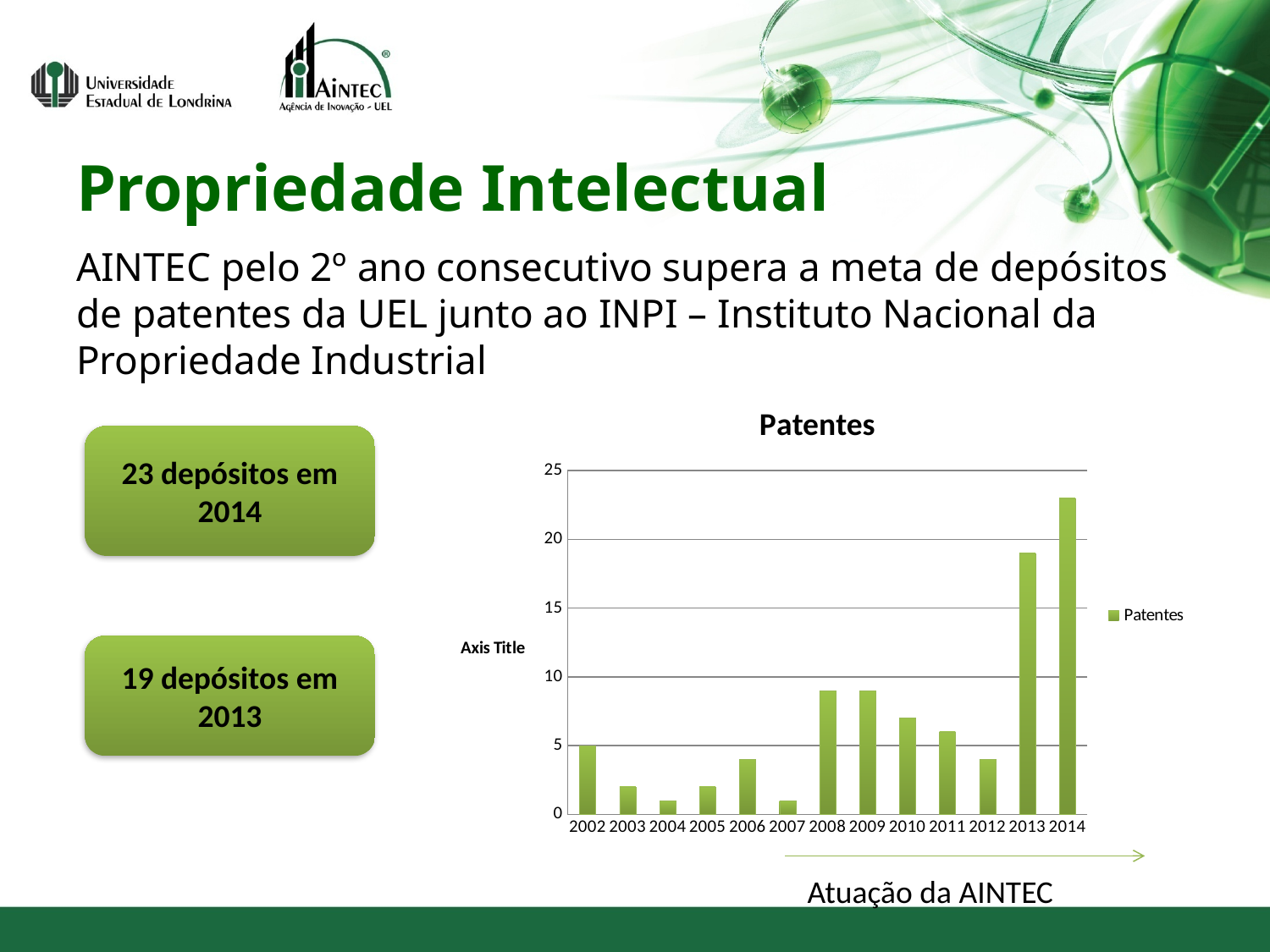
What is the difference between the number of deposits in 2014 and in 2013? 4 How many patent deposits were made in 2014? 23 Is the value for 2008 greater or less than 10? less How many years are shown on the x axis of the chart? 13 Which year has the highest number of patents in the chart? 2014 Is the value for 2003 greater or less than 5? less Which year has the larger value, 2012 or 2013? 2013 How many series does the chart legend list? 1 How many patent deposits were made in 2013? 19 Do the values rise or fall from 2012 to 2014? rise What is the title of the chart? Patentes What kind of chart is shown on the slide? bar chart